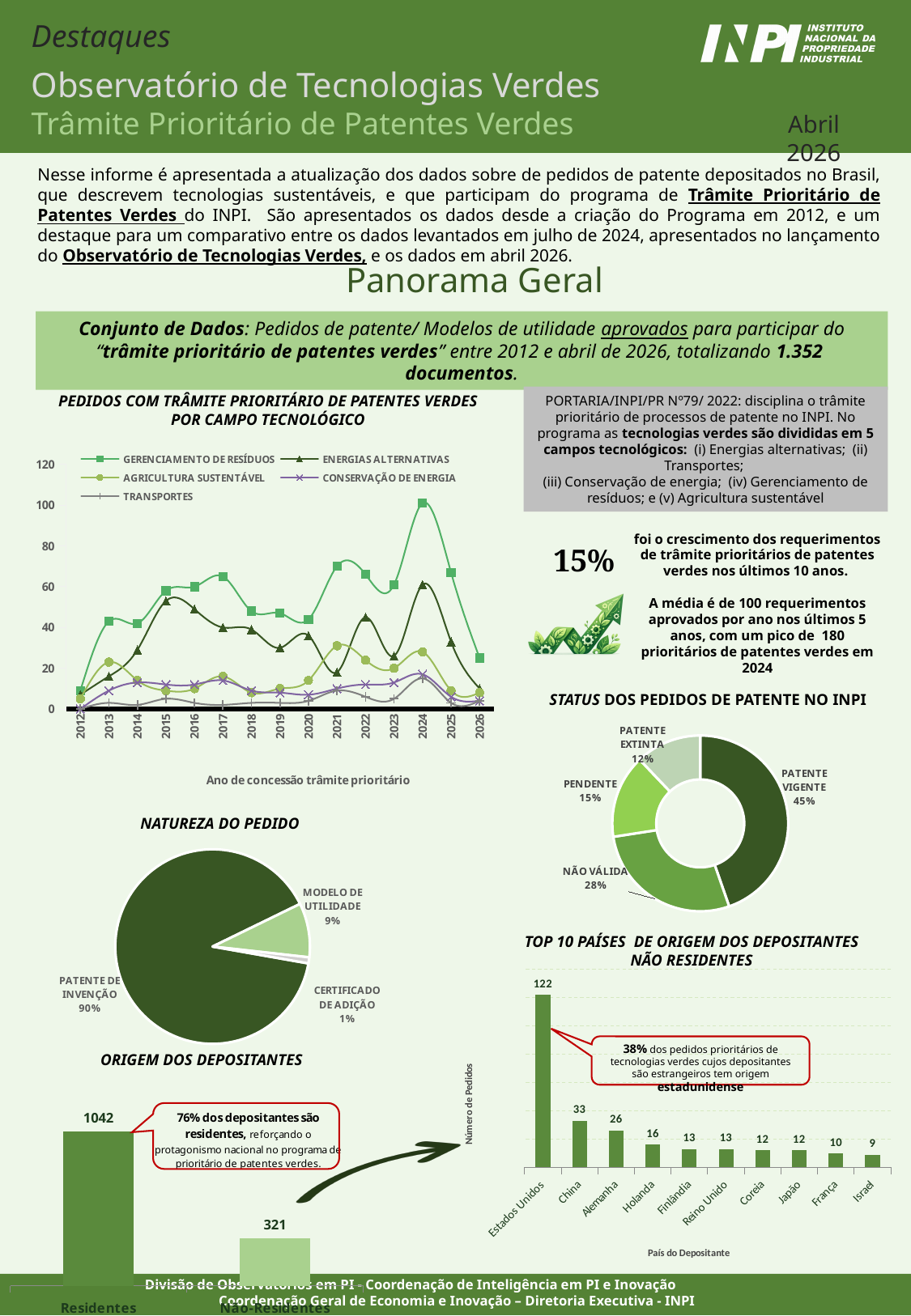
In the 'TOP 10 PAÍSES DE ORIGEM DOS DEPOSITANTES NÃO RESIDENTES' chart, which country has the highest value? Estados Unidos In the 'STATUS DOS PEDIDOS DE PATENTE NO INPI' chart, which status has the largest share? Patente Vigente In the 'NATUREZA DO PEDIDO' pie chart, what share does Modelo de Utilidade have? 9% In the 'TOP 10 PAÍSES DE ORIGEM DOS DEPOSITANTES NÃO RESIDENTES' chart, which country has the lowest value? Israel In the 'PEDIDOS COM TRÂMITE PRIORITÁRIO DE PATENTES VERDES POR CAMPO TECNOLÓGICO' chart, is the value for Gerenciamento de Resíduos in 2024 greater or less than 80? greater In the 'ORIGEM DOS DEPOSITANTES' chart, what is the difference between Residentes and Não-Residentes? 721 In the 'TOP 10 PAÍSES DE ORIGEM DOS DEPOSITANTES NÃO RESIDENTES' chart, what is the difference between Estados Unidos and Alemanha? 96 In the 'TOP 10 PAÍSES DE ORIGEM DOS DEPOSITANTES NÃO RESIDENTES' chart, how many countries are shown? 10 In the 'ORIGEM DOS DEPOSITANTES' chart, what is the value for Residentes? 1042 In the 'TOP 10 PAÍSES DE ORIGEM DOS DEPOSITANTES NÃO RESIDENTES' chart, what is the value for China? 33 In the 'STATUS DOS PEDIDOS DE PATENTE NO INPI' chart, what is the share of Não Válida? 28% How many series does the legend of the 'PEDIDOS COM TRÂMITE PRIORITÁRIO DE PATENTES VERDES POR CAMPO TECNOLÓGICO' chart list? 5